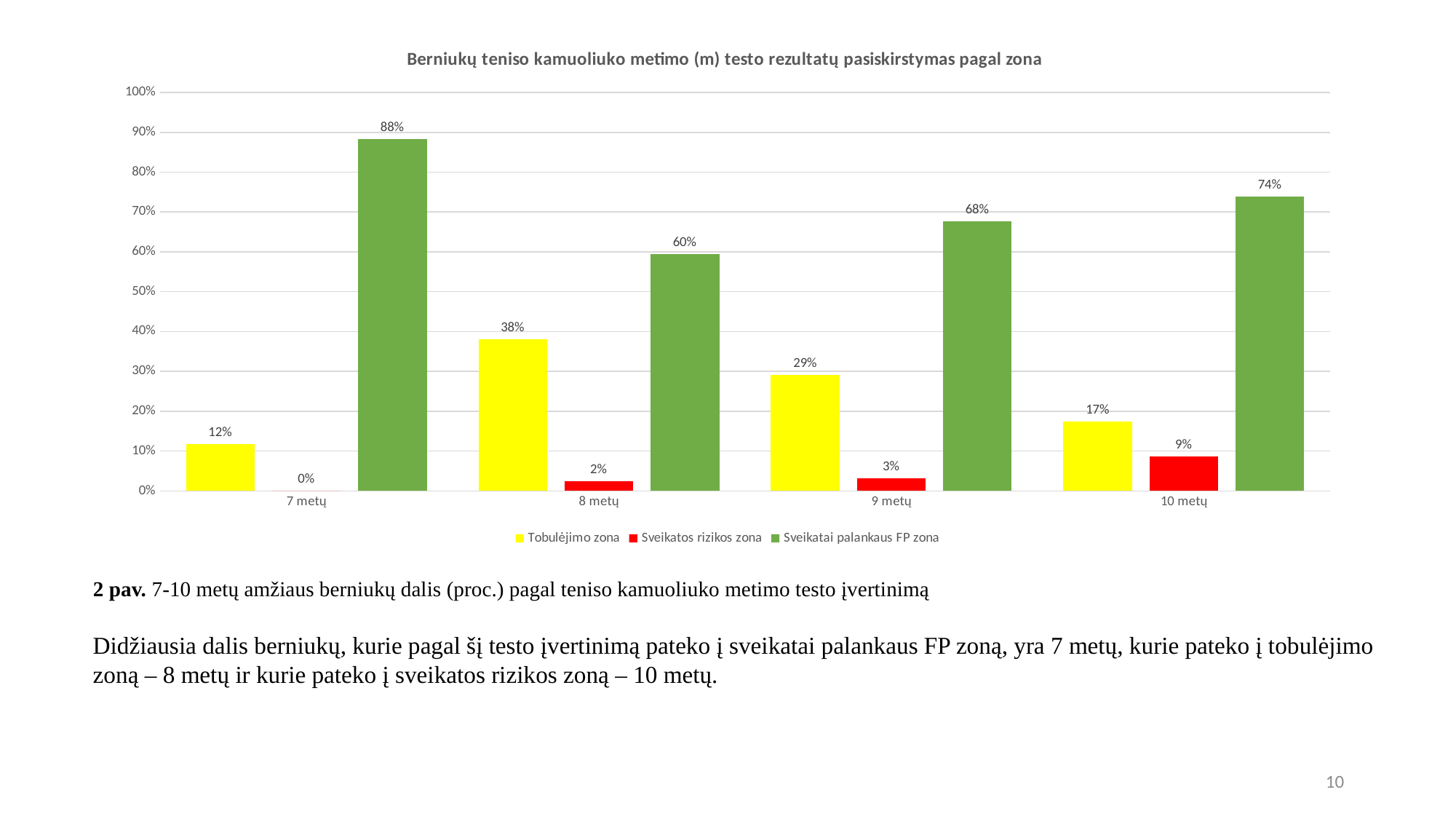
Is the value for Sveikatai palankaus FP zona for 9 metų greater or less than 60%? greater Which is larger: Tobulėjimo zona for 9 metų or Tobulėjimo zona for 10 metų? Tobulėjimo zona for 9 metų Which age group has the highest value for Sveikatai palankaus FP zona? 7 metų Which age group has the lowest value for Tobulėjimo zona? 7 metų What is the difference between the Sveikatai palankaus FP zona values for 7 metų and 8 metų? 28% What is the value for Sveikatai palankaus FP zona for 7 metų? 88% How many series does the legend list? 3 What kind of chart is shown on the slide? bar chart Which colour represents Sveikatos rizikos zona in the chart? red What is the value for Tobulėjimo zona for 8 metų? 38% How many age groups are shown on the x axis? 4 What is the value for Sveikatos rizikos zona for 10 metų? 9%